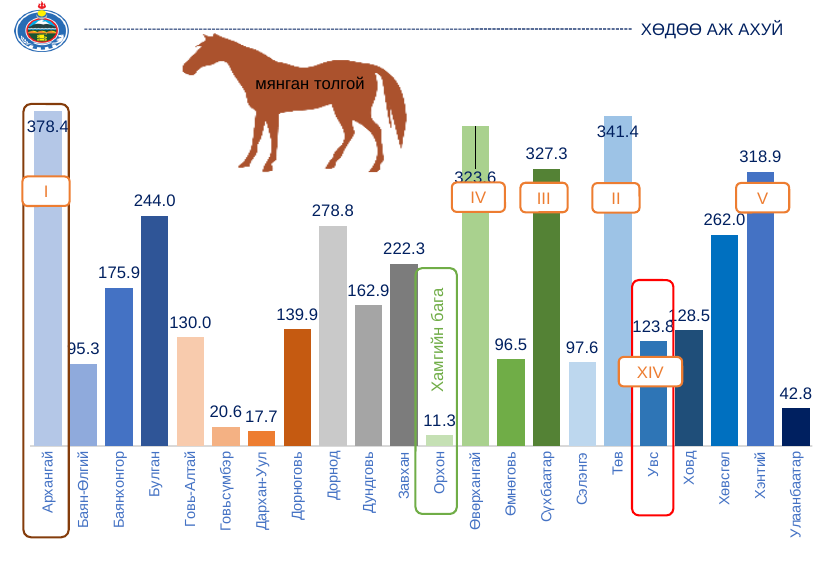
Which category is marked with the rank label "XIV"? Увс What is the difference between the values for Архангай and Орхон? 367.1 What kind of chart is shown on the slide? Bar chart What is the value for Дорнод? 278.8 What is the value for Архангай? 378.4 Which category has the lowest value? Орхон What is the value for Сүхбаатар? 327.3 What is the difference between the values for Төв and Сүхбаатар? 14.1 Which is larger, the value for Булган or the value for Хөвсгөл? Хөвсгөл How many categories are shown in the chart? 22 What is the value for Говьсүмбэр? 20.6 Which category has the highest value? Архангай